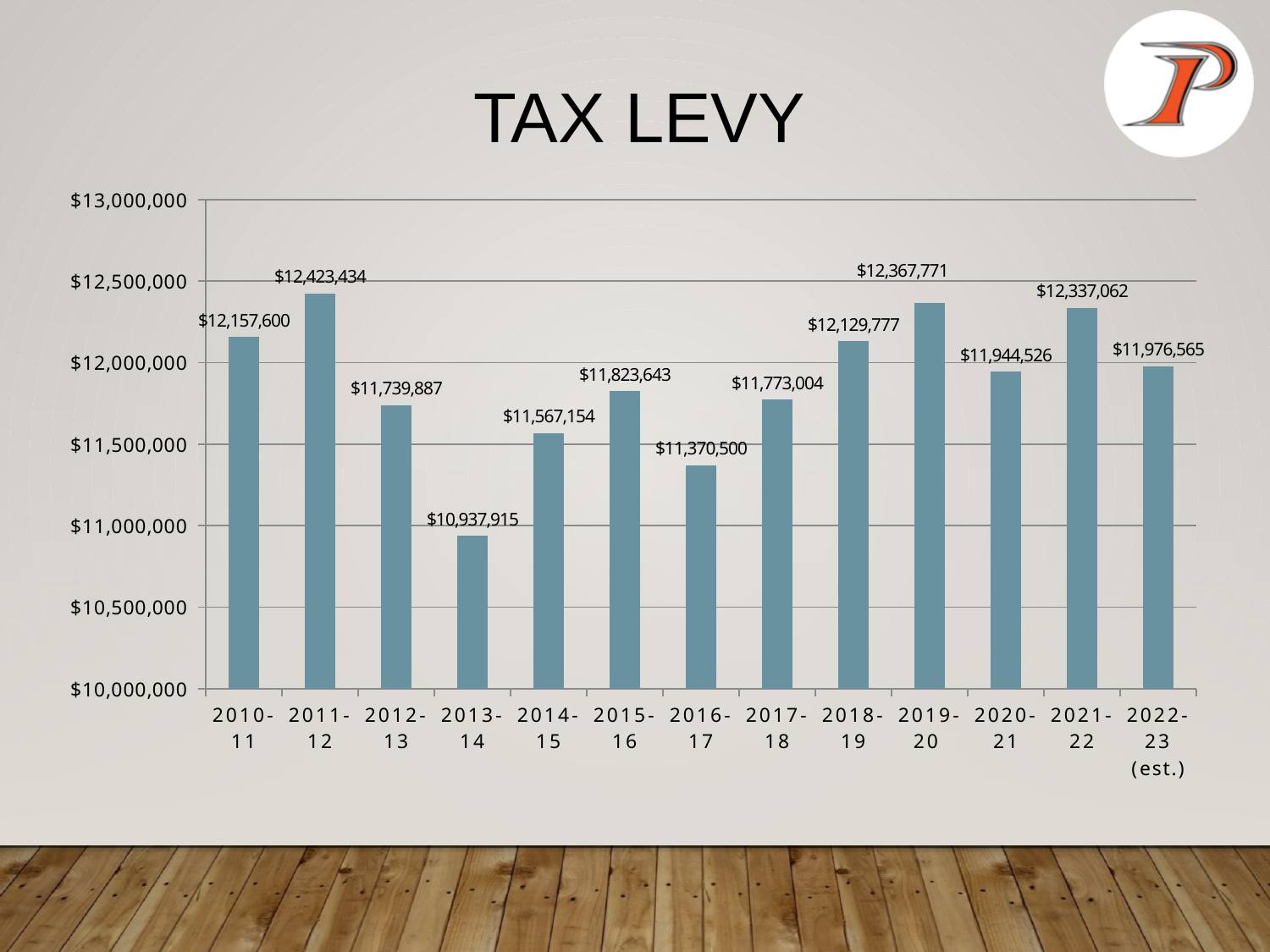
What is the difference between the tax levy in 2011-12 and 2010-11? $265,834 What kind of chart is shown on the slide? bar chart What is the difference between the tax levy in 2019-20 and 2018-19? $237,994 What is the tax levy for 2013-14? $10,937,915 What is the tax levy for 2019-20? $12,367,771 What is the title of the chart? TAX LEVY Which year has the highest tax levy? 2011-12 Which is larger, the tax levy for 2015-16 or for 2016-17? 2015-16 How many years are shown on the chart? 13 What is the estimated tax levy for 2022-23? $11,976,565 Which year has the lowest tax levy? 2013-14 Is the tax levy for 2016-17 greater or less than $11,500,000? less